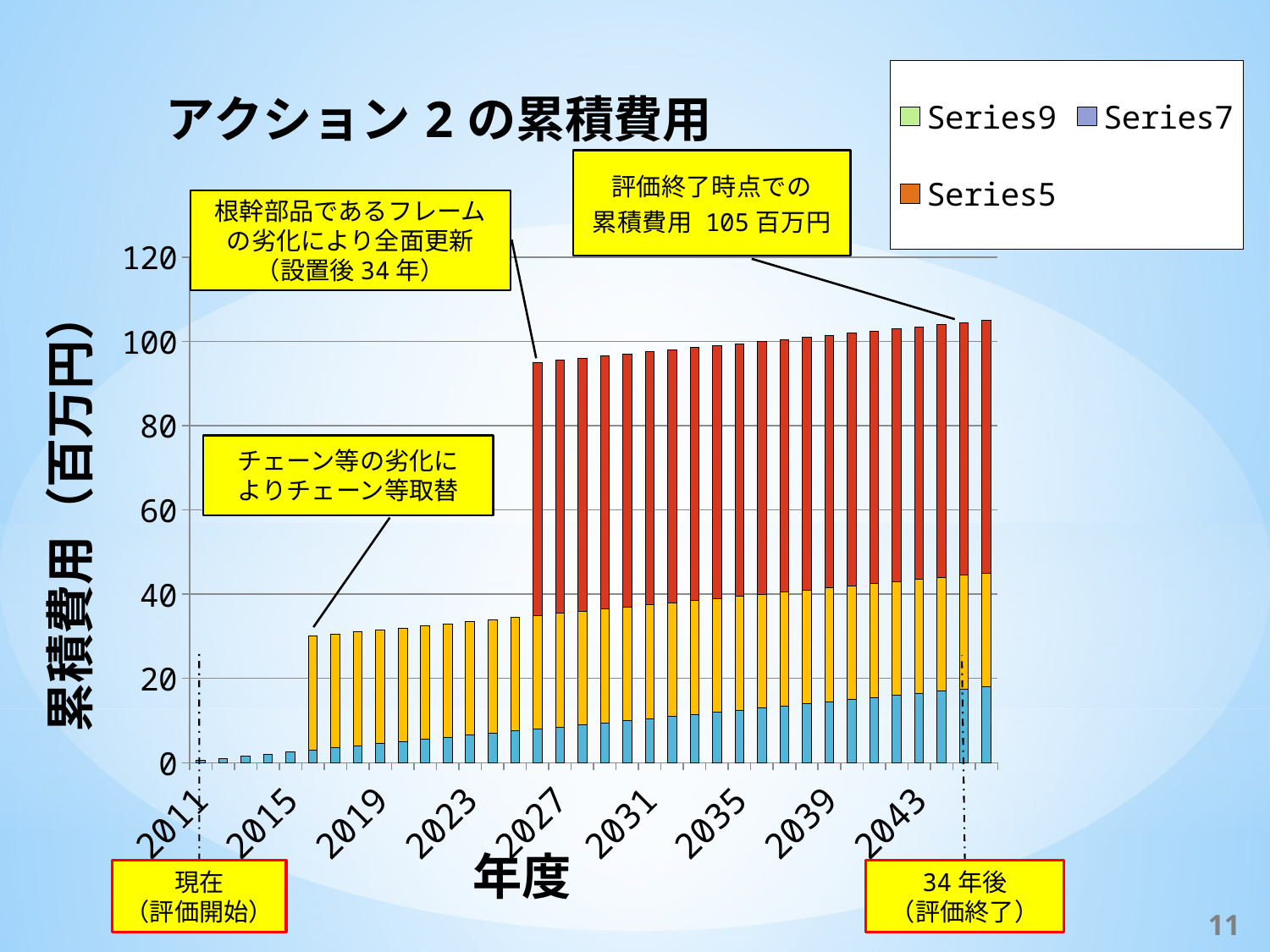
According to the annotation, what is the cumulative cost at the end of the evaluation period? 105 百万円 Is the total value of the bar for 2035 greater or less than 80? greater What is the title of the chart? アクション２の累積費用 Do the cumulative cost values rise or fall as the years increase along the x axis? rise What kind of chart is shown on the slide? bar chart Is the total value of the bar for 2019 greater or less than 40? less Is the total value of the bar for 2027 greater or less than 80? greater How many series does the legend list? 3 Which bar is taller, 2015 or 2019? 2019 What is the label of the vertical axis? 累積費用（百万円） Which bar is taller, 2023 or 2031? 2031